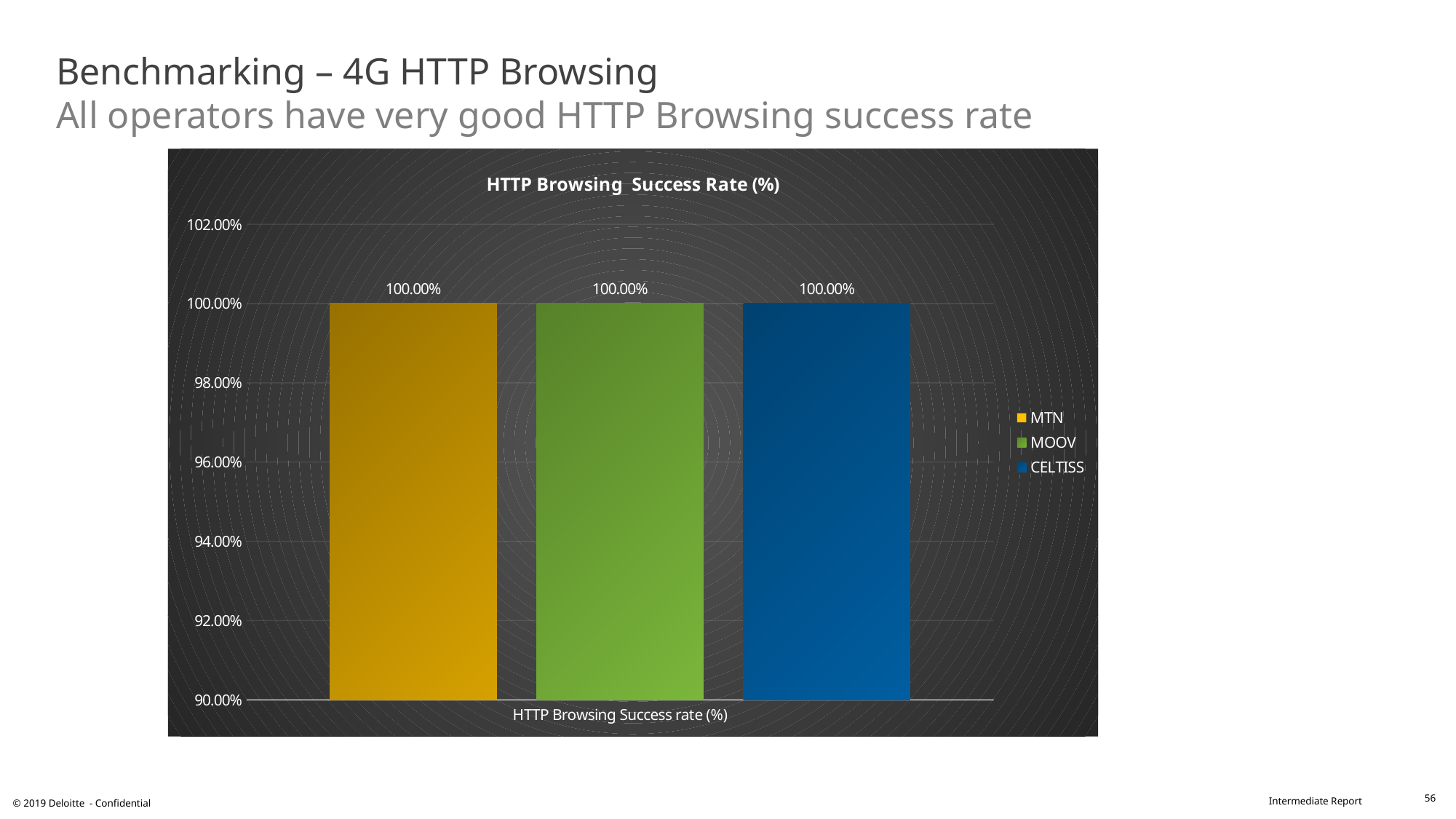
Is the value for MOOV greater or less than 98.00%? greater What kind of chart is shown on the slide? bar chart What is the HTTP Browsing success rate for CELTISS? 100.00% What is the lowest value shown on the y axis? 90.00% Which colour represents CELTISS in the legend? blue What is the HTTP Browsing success rate for MTN? 100.00% What is the difference between the MTN and CELTISS HTTP Browsing success rates? 0.00% How many series does the legend list? 3 What is the title of the chart? HTTP Browsing Success Rate (%) What is the HTTP Browsing success rate for MOOV? 100.00%